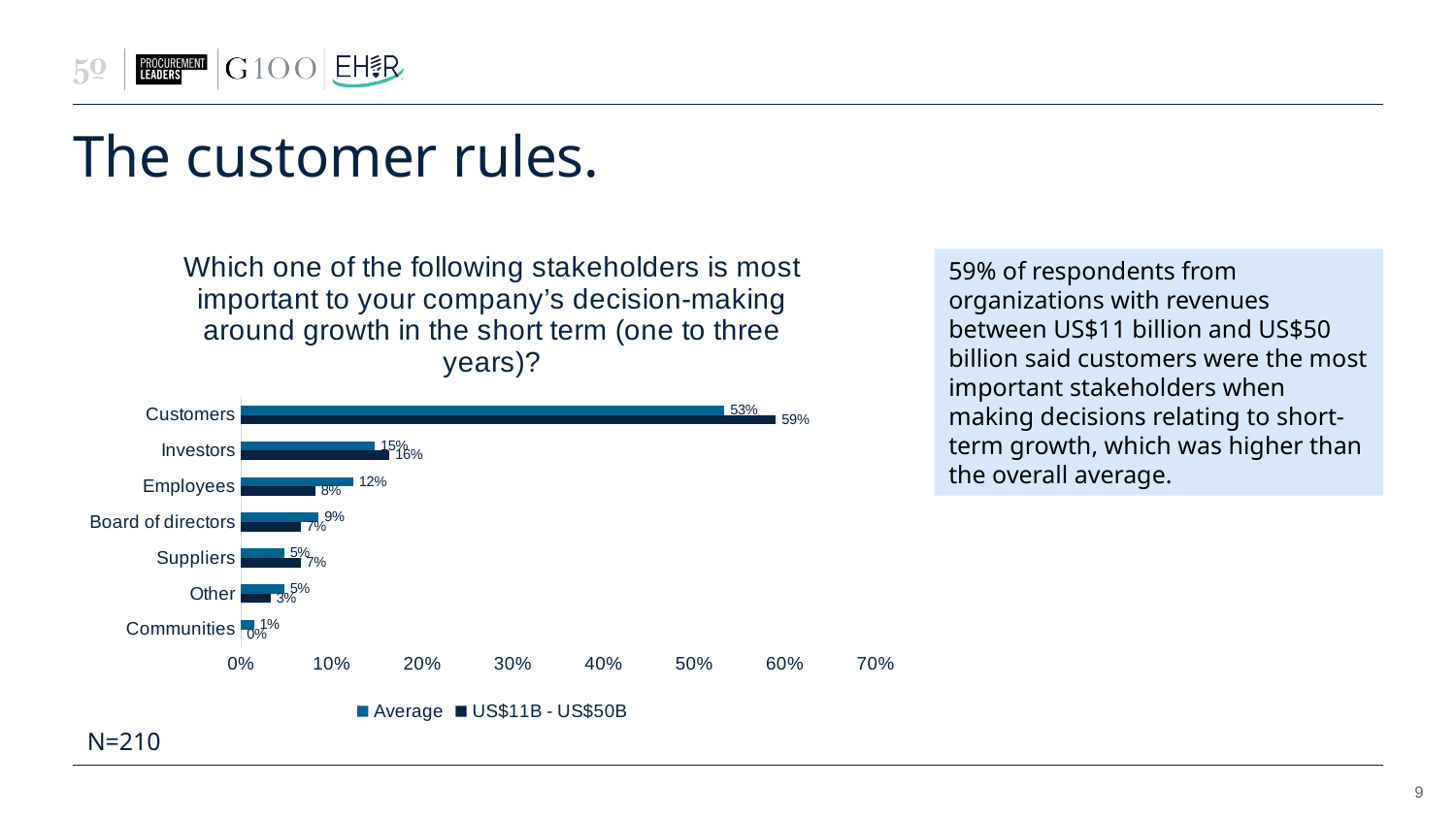
How many series does the legend list? 2 Which stakeholder has the lowest US$11B - US$50B value? Communities What is the US$11B - US$50B value for Customers? 59% What is the Average value for Employees? 12% For Employees, which is larger: the Average value or the US$11B - US$50B value? Average What is the Average value for Customers? 53% How many stakeholder categories are shown in the chart? 7 What is the difference between the US$11B - US$50B value and the Average value for Customers? 6% What are the two series named in the chart legend? Average and US$11B - US$50B Which stakeholder has the highest Average value? Customers What is the US$11B - US$50B value for Investors? 16% What kind of chart is shown on the slide? Bar chart